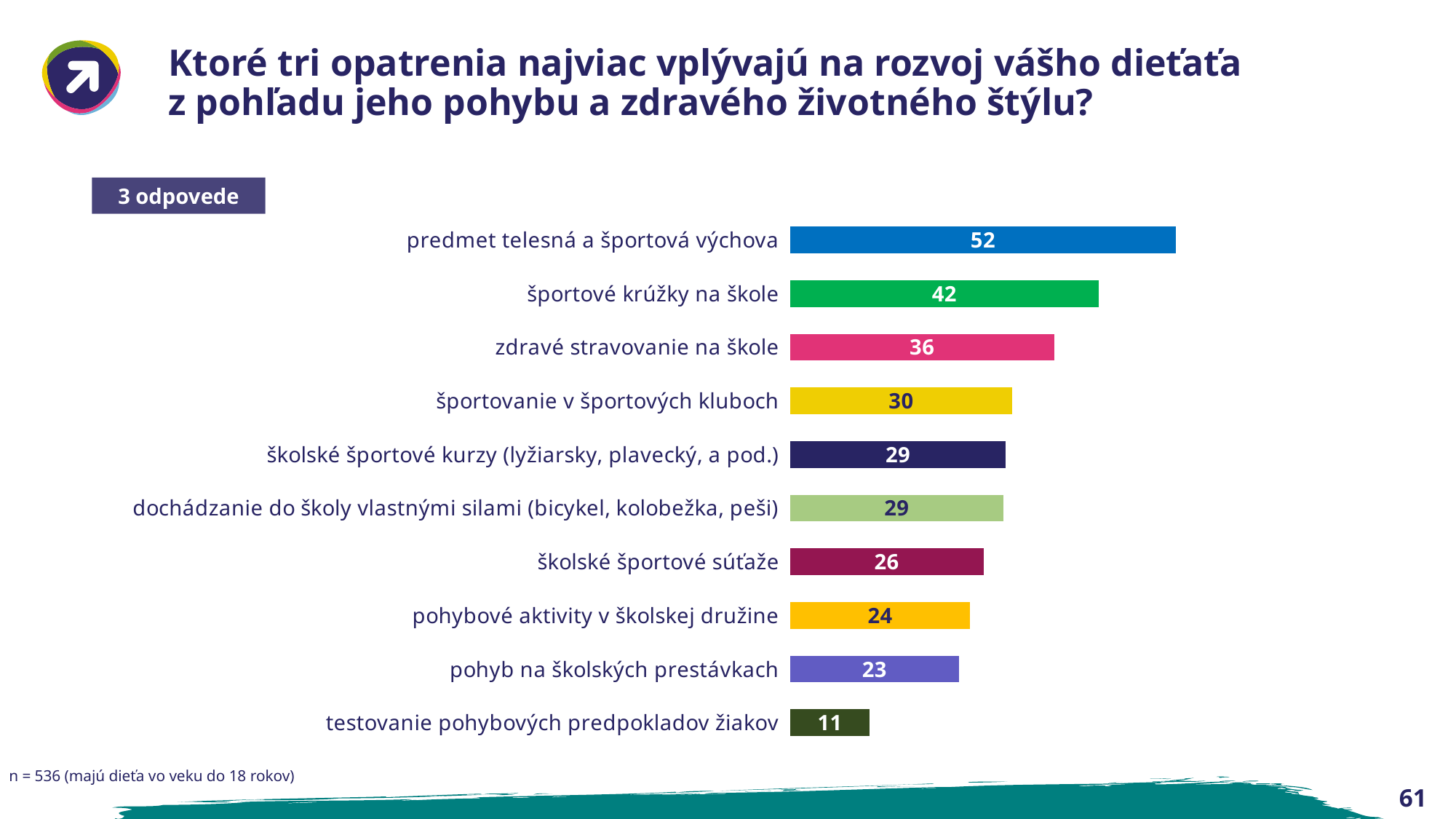
What is the sample size stated at the bottom of the slide? n = 536 Which category has the highest value? predmet telesná a športová výchova What is the value for "zdravé stravovanie na škole"? 36 What kind of chart is shown on the slide? bar chart What is the difference between the values for "predmet telesná a športová výchova" and "testovanie pohybových predpokladov žiakov"? 41 What is the value for "predmet telesná a športová výchova"? 52 Which is larger: the value for "pohybové aktivity v školskej družine" or the value for "zdravé stravovanie na škole"? zdravé stravovanie na škole What is the difference between the values for "športové krúžky na škole" and "športovanie v športových kluboch"? 12 What is the value for "školské športové súťaže"? 26 How many categories are shown in the chart? 10 What is the value for "pohyb na školských prestávkach"? 23 Which category has the lowest value? testovanie pohybových predpokladov žiakov